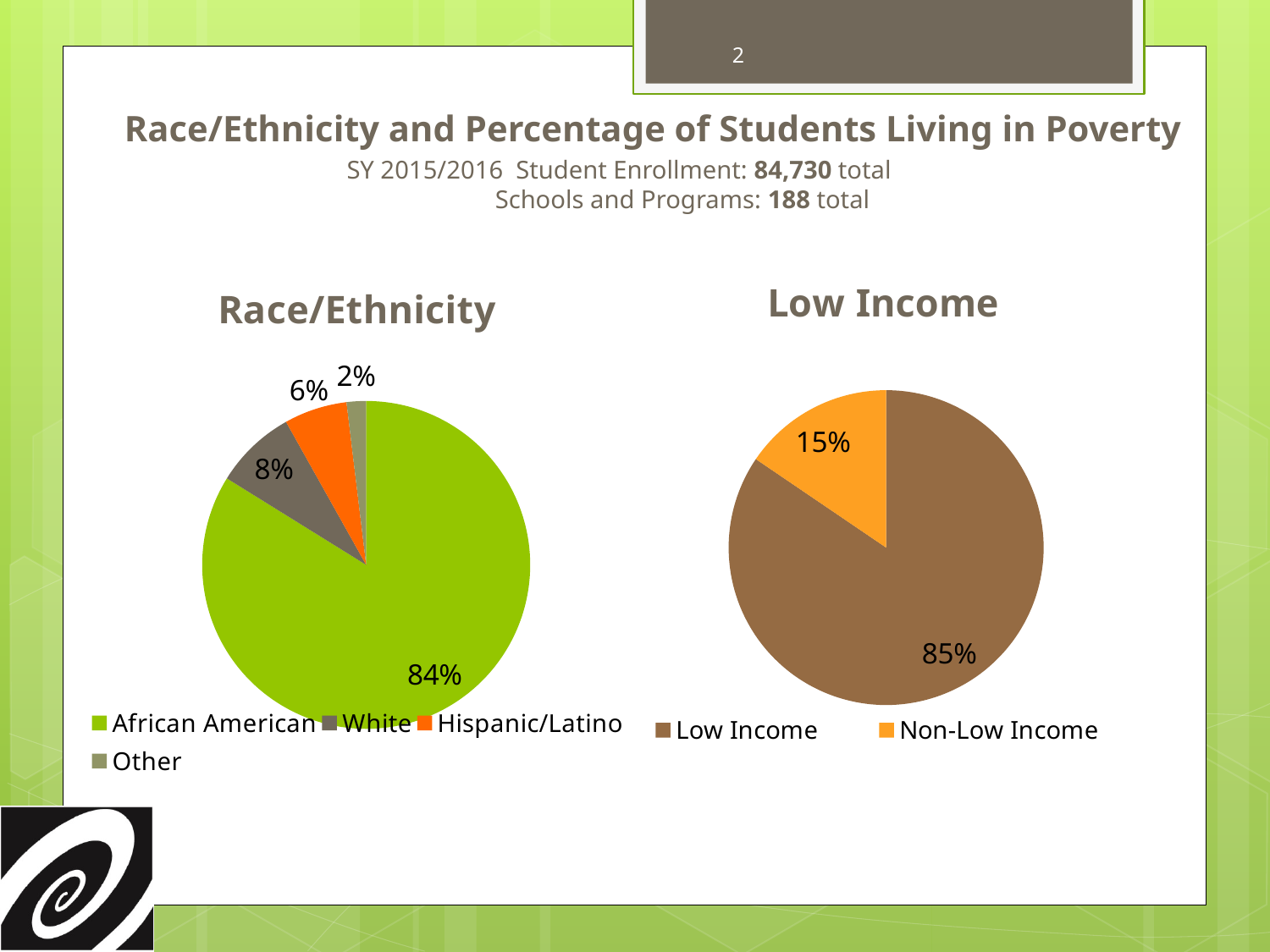
In the Race/Ethnicity chart, what share of students are Hispanic/Latino? 6% In the Race/Ethnicity chart, what share of students are African American? 84% In the Race/Ethnicity chart, what share of students are in the Other category? 2% In the Low Income chart, what share of students are Low Income? 85% In the Race/Ethnicity chart, how many categories are shown? 4 In the Low Income chart, what share of students are Non-Low Income? 15% In the Race/Ethnicity chart, what is the difference between the White and Hispanic/Latino shares? 2% In the Low Income chart, which is larger, Low Income or Non-Low Income? Low Income In the Race/Ethnicity chart, which category has the smallest slice? Other In the Race/Ethnicity chart, what share of students are White? 8% In the Race/Ethnicity chart, which category has the largest slice? African American What kind of chart is the Low Income chart? Pie chart